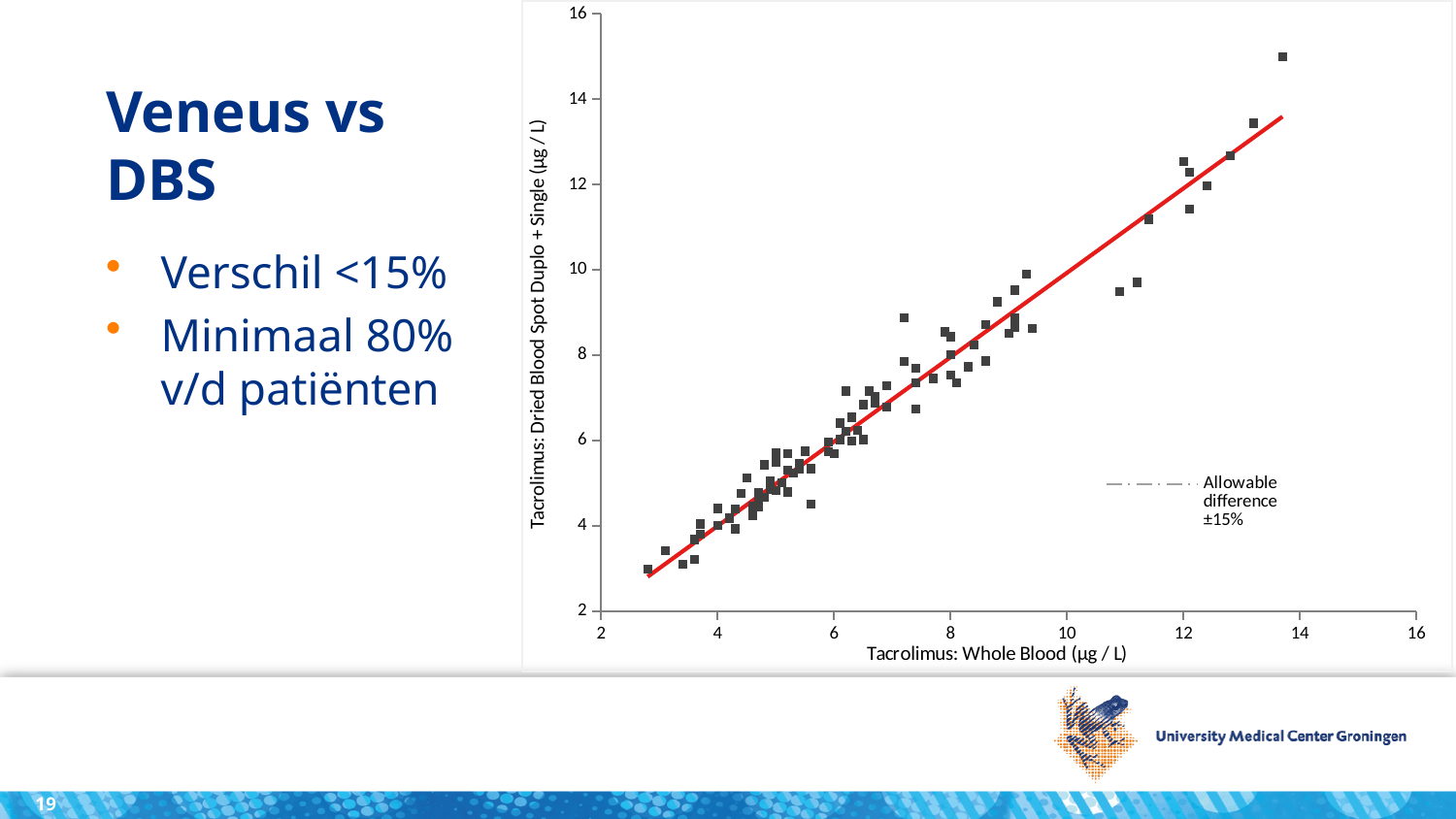
Is the x value of the rightmost plotted point greater or less than 14? less What kind of chart is shown on the slide? scatter plot Are there any plotted points with an x value greater than 14? no What is the label of the x axis of the chart? Tacrolimus: Whole Blood (µg / L) What is the label of the y axis of the chart? Tacrolimus: Dried Blood Spot Duplo + Single (µg / L) What is the minimum value shown on the x axis? 2 Is the y value of the highest plotted point greater or less than 14? greater Do the plotted values rise or fall as the x-axis value increases? rise